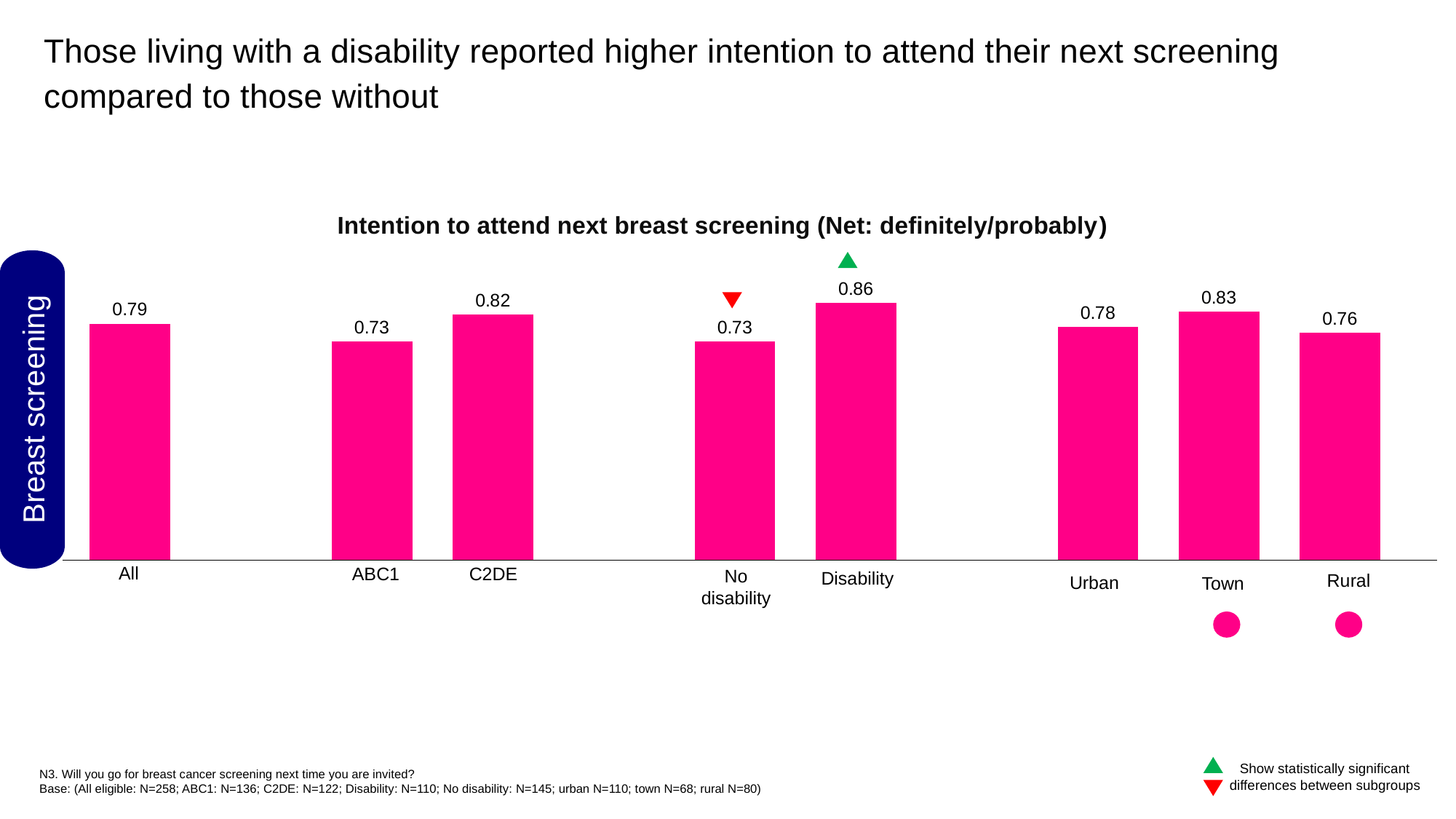
What is the difference between the values for C2DE and ABC1? 0.09 What is the value for All? 0.79 What is the value for Rural? 0.76 Which is larger, the value for ABC1 or the value for C2DE? C2DE What is the title of the chart? Intention to attend next breast screening (Net: definitely/probably) What is the value for Town? 0.83 Which is larger, the value for Town or the value for Urban? Town What is the difference between the values for Disability and No disability? 0.13 What is the value for Disability? 0.86 How many categories are plotted in the chart? 8 Which category has the highest value? Disability What kind of chart is shown? Bar chart